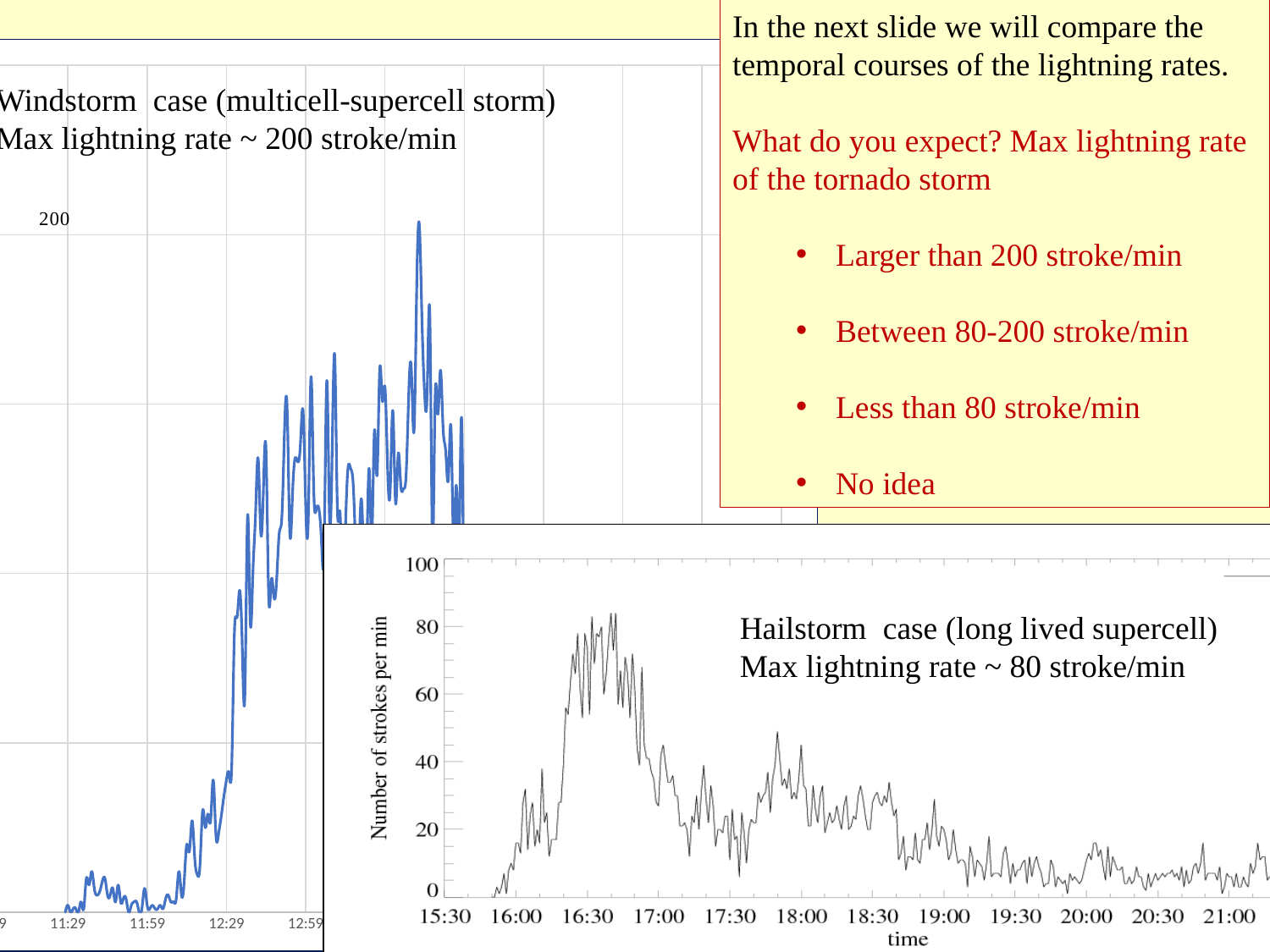
On the Hailstorm case chart, do the values generally rise or fall from 17:00 to 21:00? fall On the Hailstorm case chart, what is the label of the horizontal axis? time On the Windstorm case chart, do the values generally rise or fall from 11:29 to 12:29? rise On the Hailstorm case chart, what is the label of the vertical axis? Number of strokes per min On the Hailstorm case chart, is the value at 16:30 greater or less than 40? greater On the Windstorm case chart, is the value at 12:29 greater or less than 200? less On the Windstorm case chart, is the value at 11:59 greater or less than 200? less What kind of chart is the Hailstorm case chart at the bottom right? line chart What kind of chart is the Windstorm case chart on the left? line chart Which chart reaches a higher peak lightning rate, the Windstorm case chart or the Hailstorm case chart? Windstorm case chart